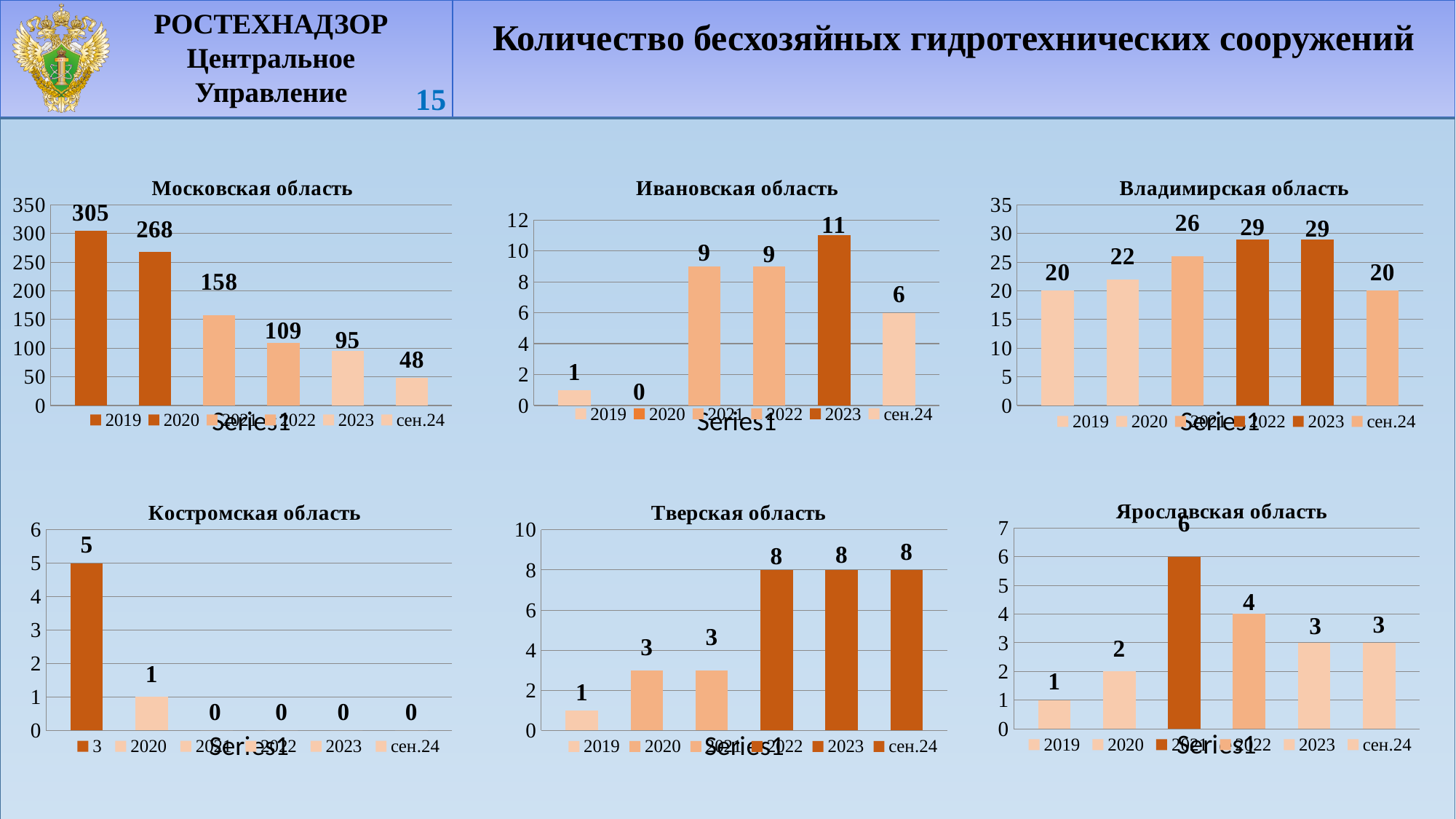
In the Московская область chart, do the values rise or fall from 2019 to сен.24? fall In the Московская область chart, what is the difference between the 2019 and 2020 values? 37 In the Владимирская область chart, what is the value for сен.24? 20 What type of chart is the Тверская область chart? bar chart In the Владимирская область chart, which is larger, the value for 2020 or the value for 2022? 2022 How many bars are plotted in the Ярославская область chart? 6 In the Московская область chart, what is the value for 2019? 305 In the Ивановская область chart, which year has the highest value? 2023 In the Тверская область chart, what is the value for 2023? 8 In the Ивановская область chart, what is the value for 2020? 0 In the Ярославская область chart, what is the difference between the highest value and the value for 2022? 2 In the Костромская область chart, what is the value of the first (tallest) bar? 5